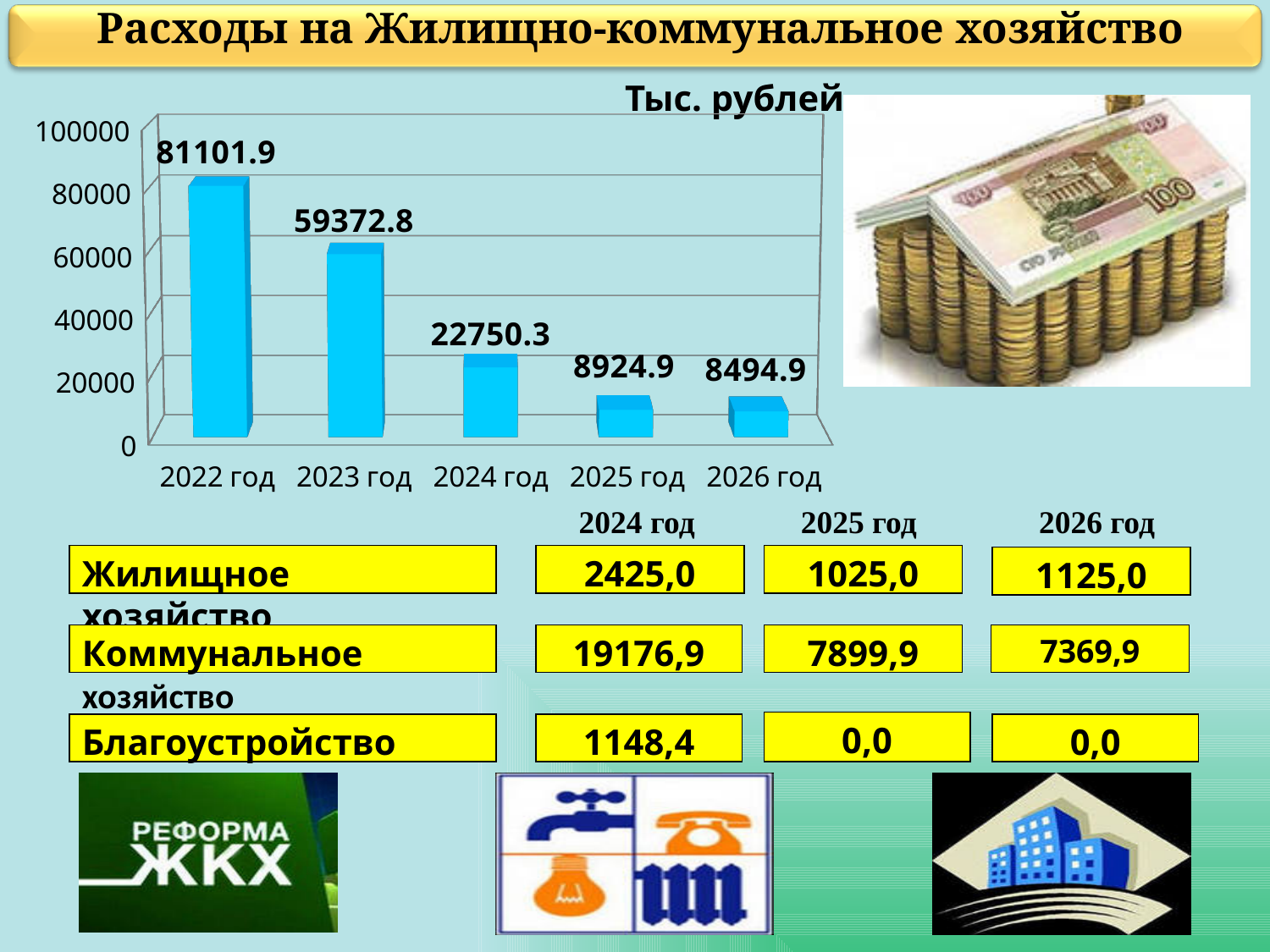
What is the value for 2024 год on the chart? 22750.3 Is the value for 2025 год greater or less than 20000? less What type of chart is shown on the slide? bar chart Do the values rise or fall from 2022 год to 2026 год? fall How many years are shown on the chart? 5 Which is larger, the value for 2023 год or the value for 2024 год? 2023 год What is the value for 2026 год on the chart? 8494.9 Which year has the highest value on the chart? 2022 год What is the difference between the values for 2022 год and 2023 год? 21729.1 What is the value for 2022 год on the chart? 81101.9 Which year has the lowest value on the chart? 2026 год What is the difference between the values for 2024 год and 2025 год? 13825.4